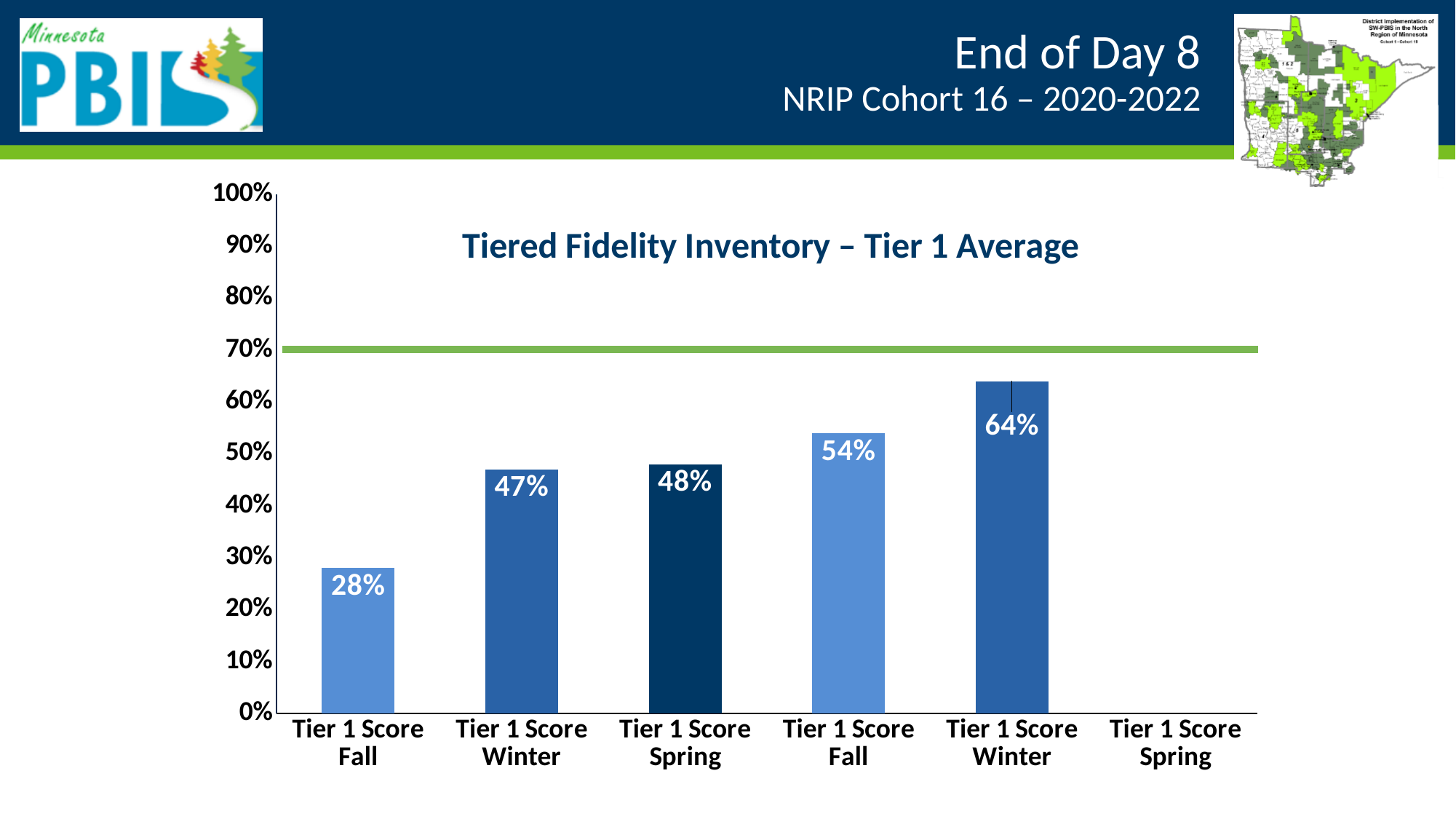
Which is larger, the second Tier 1 Score Fall bar or the first Tier 1 Score Spring bar? The second Tier 1 Score Fall bar (54%) What is the value of the second Tier 1 Score Fall bar (the fourth bar from the left)? 54% Which bar has the highest value? The second Tier 1 Score Winter bar (64%) Is the value of the second Tier 1 Score Winter bar greater or less than the 70% green line? less What kind of chart is shown on the slide? Bar chart What is the value of the second Tier 1 Score Winter bar (the fifth bar from the left)? 64% What is the title of the chart? Tiered Fidelity Inventory – Tier 1 Average What is the difference between the second Tier 1 Score Winter bar (64%) and the first Tier 1 Score Fall bar (28%)? 36% What is the difference between the first Tier 1 Score Winter bar (47%) and the first Tier 1 Score Spring bar (48%)? 1% Which bar has the lowest value? The first Tier 1 Score Fall bar (28%) How many bars are plotted on the chart? 5 What is the value of the first Tier 1 Score Fall bar? 28%